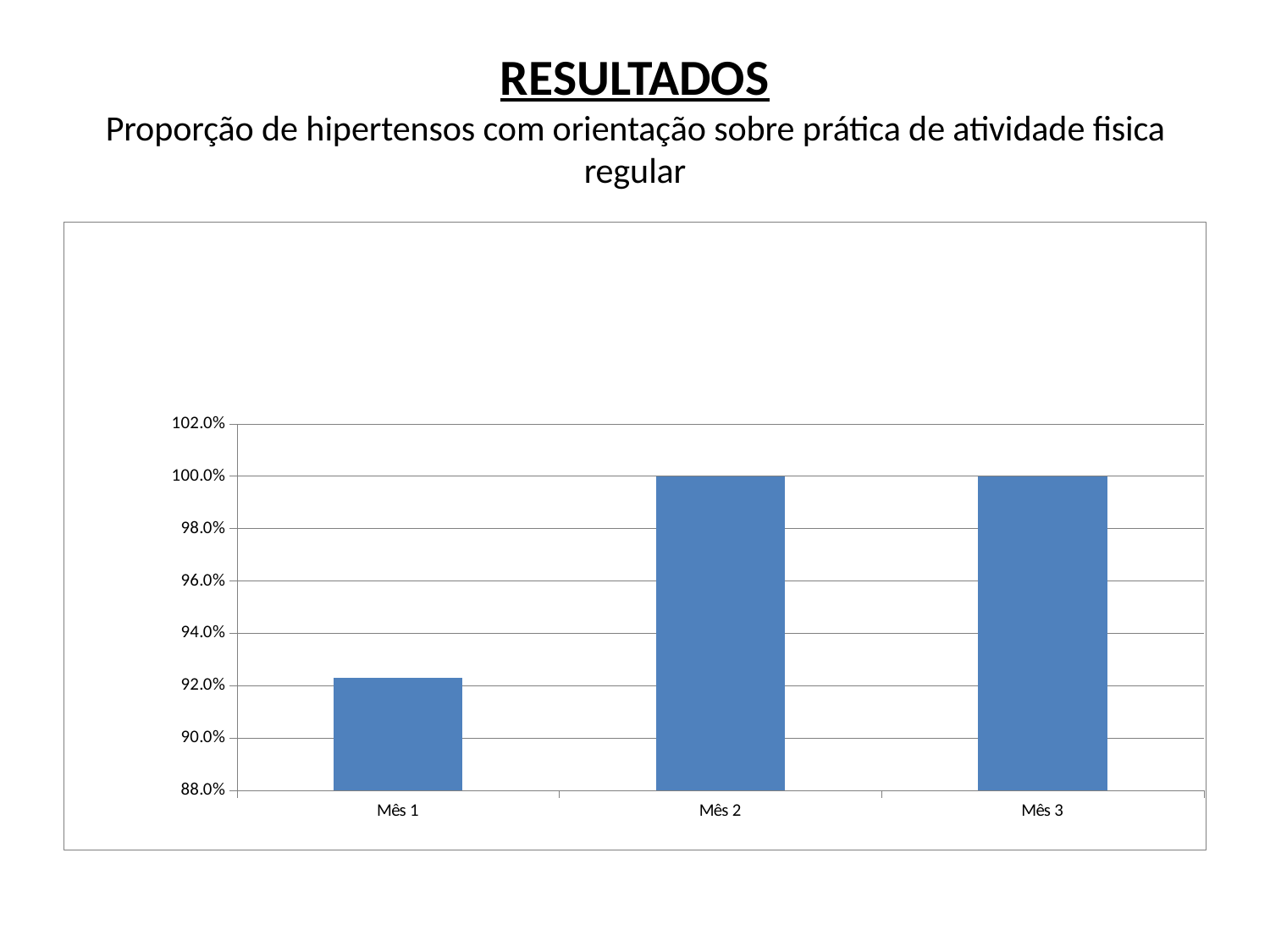
Which is larger, the value for Mês 1 or the value for Mês 2? Mês 2 What is the value for Mês 2? 100.0% Which category has the lowest value? Mês 1 What colour are the bars in the chart? blue What is the lowest value shown on the y axis of the chart? 88.0% Is the value for Mês 1 greater or less than 94.0%? less What is the value for Mês 3? 100.0% What is the difference between the values for Mês 2 and Mês 3? 0.0% How many categories are plotted on the x axis of the chart? 3 What kind of chart is shown on the slide? bar chart Is the value for Mês 1 greater or less than 90.0%? greater Do the values rise or fall from Mês 1 to Mês 3? rise